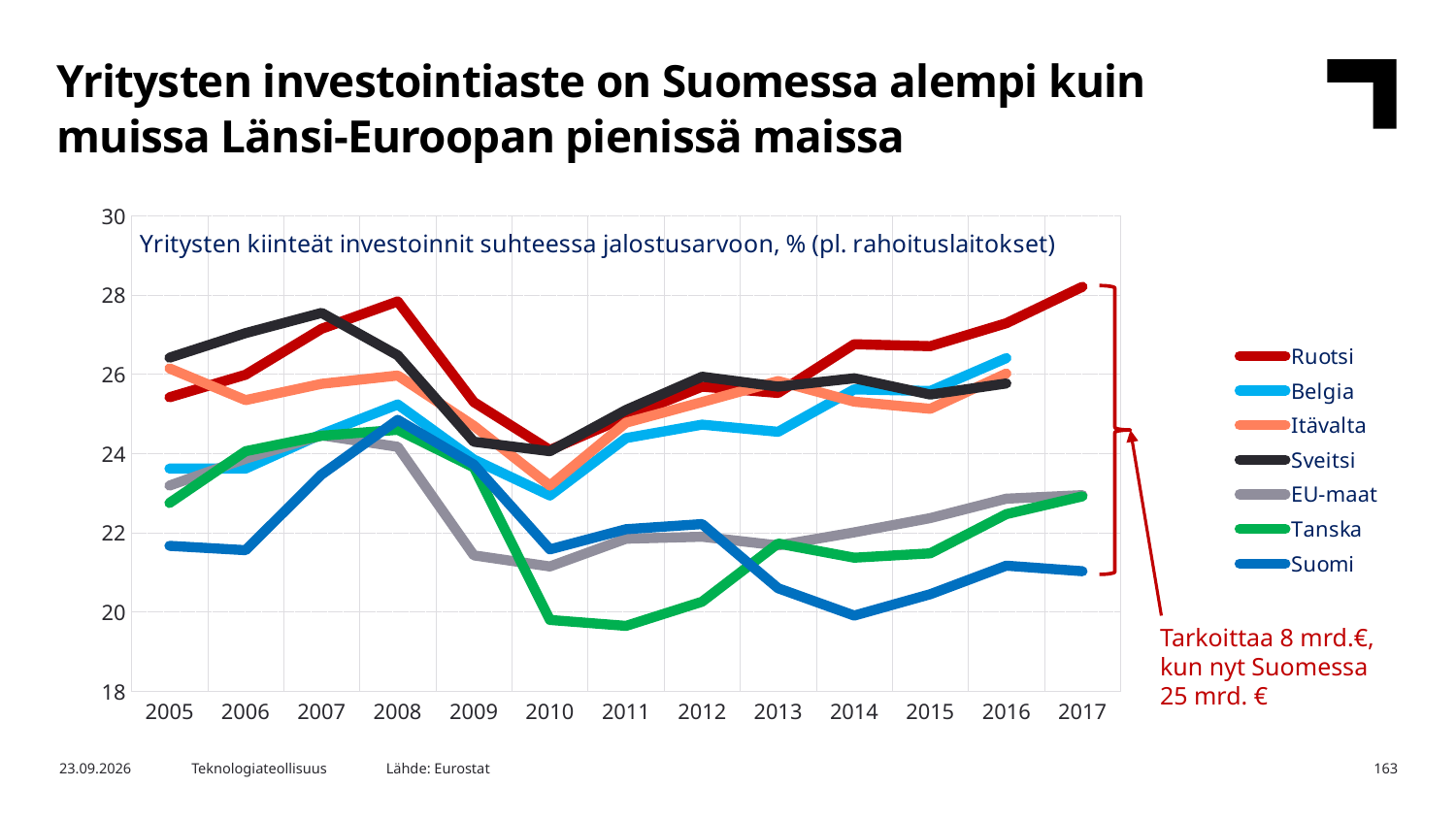
How many series does the legend list? 7 What type of chart is shown on the slide? Line chart Does the value for Ruotsi rise or fall from 2013 to 2017? rise Is the value for Sveitsi in 2007 greater or less than 26? greater Is the value for EU-maat in 2009 greater or less than 22? less Which series has the lowest value in 2017? Suomi Which country has the highest value in 2017? Ruotsi How many years are shown on the x axis? 13 Is the value for Suomi in 2017 greater or less than 22? less Which series has the lowest value in 2005? Suomi In 2017, which is larger: the value for Ruotsi or the value for Suomi? Ruotsi Which series has the lowest value in 2011? Tanska